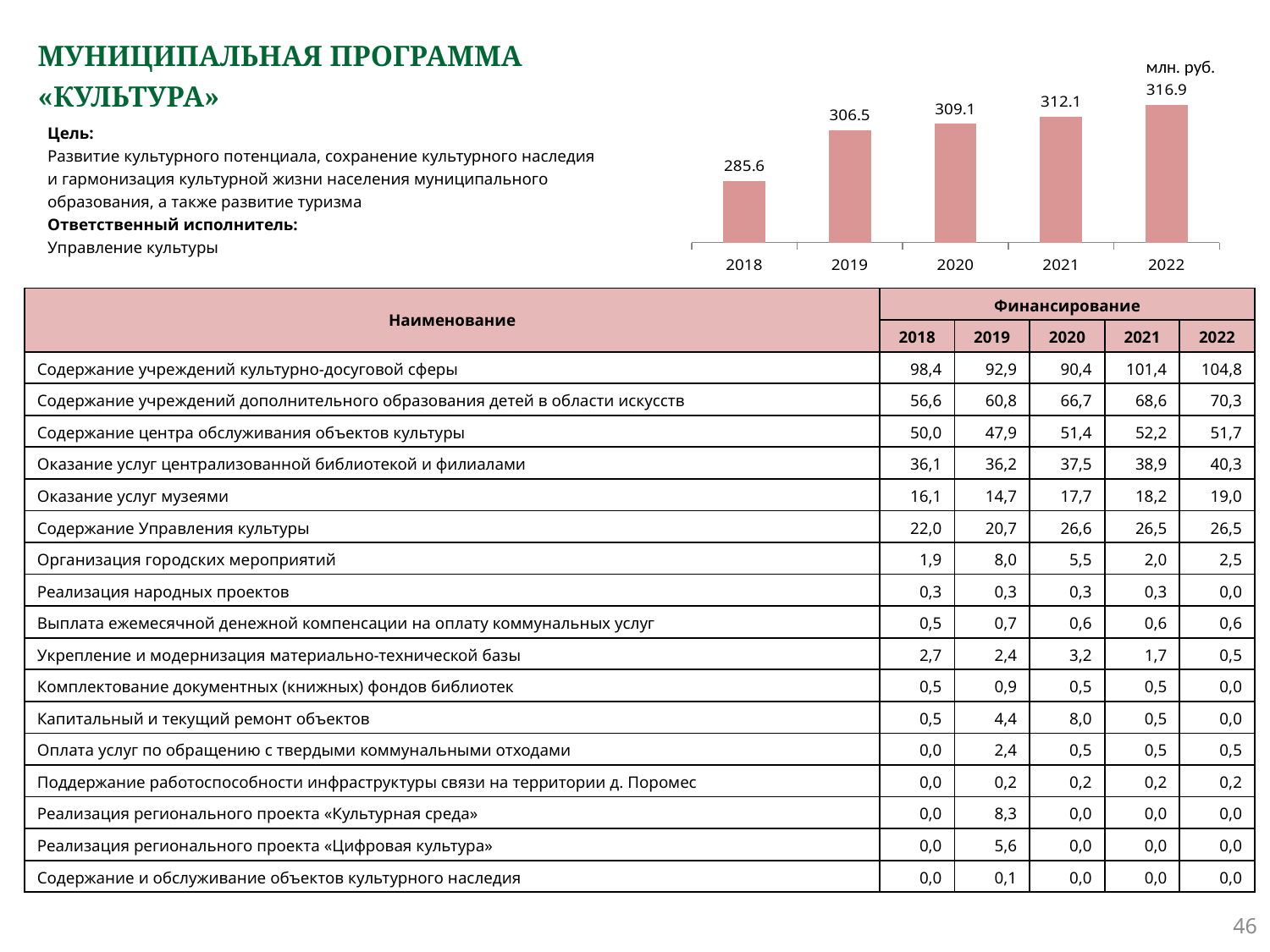
Do the values in the bar chart rise or fall from 2018 to 2022? rise What is the difference between the values for 2022 and 2018 in the bar chart? 31.3 What is the value for 2018 in the bar chart? 285.6 What kind of chart is shown on the slide? bar chart How many years are shown in the bar chart? 5 Which year has the lowest value in the bar chart? 2018 Which is larger in the bar chart, the value for 2019 or the value for 2021? 2021 What unit is indicated above the bar chart? млн. руб. What is the value for 2022 in the bar chart? 316.9 What is the difference between the values for 2021 and 2020 in the bar chart? 3.0 Which year has the highest value in the bar chart? 2022 What is the value for 2020 in the bar chart? 309.1